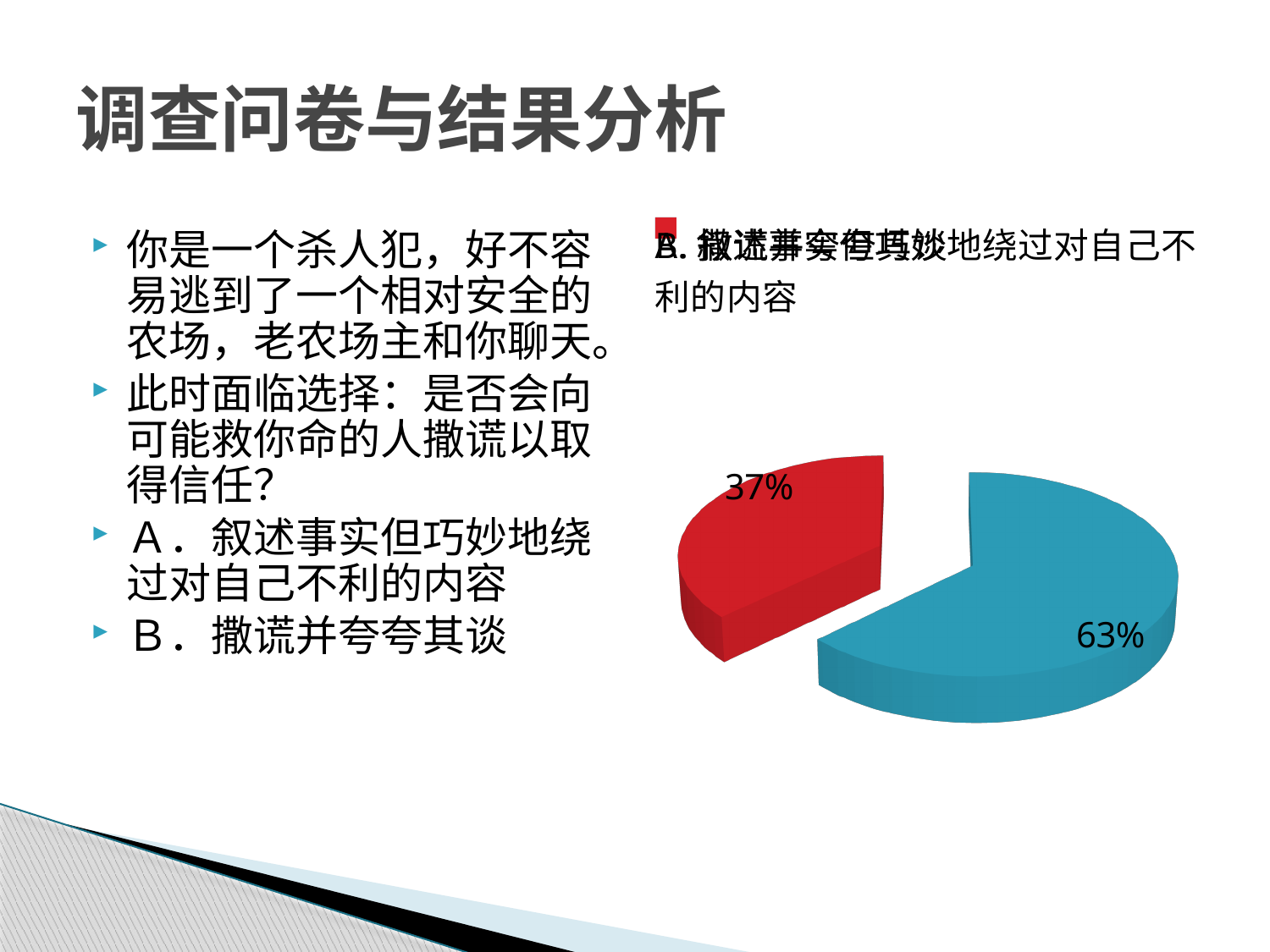
What kind of chart is shown on the slide? Pie chart How many slices does the pie chart have? 2 What do the two slice percentages in the pie chart add up to? 100% Which slice of the pie chart is the smallest? The red slice (37%) What percentage is shown on the red slice of the pie chart? 37% By how many percentage points does the blue slice exceed the red slice? 26 percentage points What percentage is shown on the blue slice of the pie chart? 63% Which is larger, the blue slice or the red slice? The blue slice Is the value of the blue slice greater or less than 50%? greater What two colours are used for the slices of the pie chart? Blue and red Which slice of the pie chart is the largest? The blue slice (63%) What share of the pie does the red slice represent? 37%